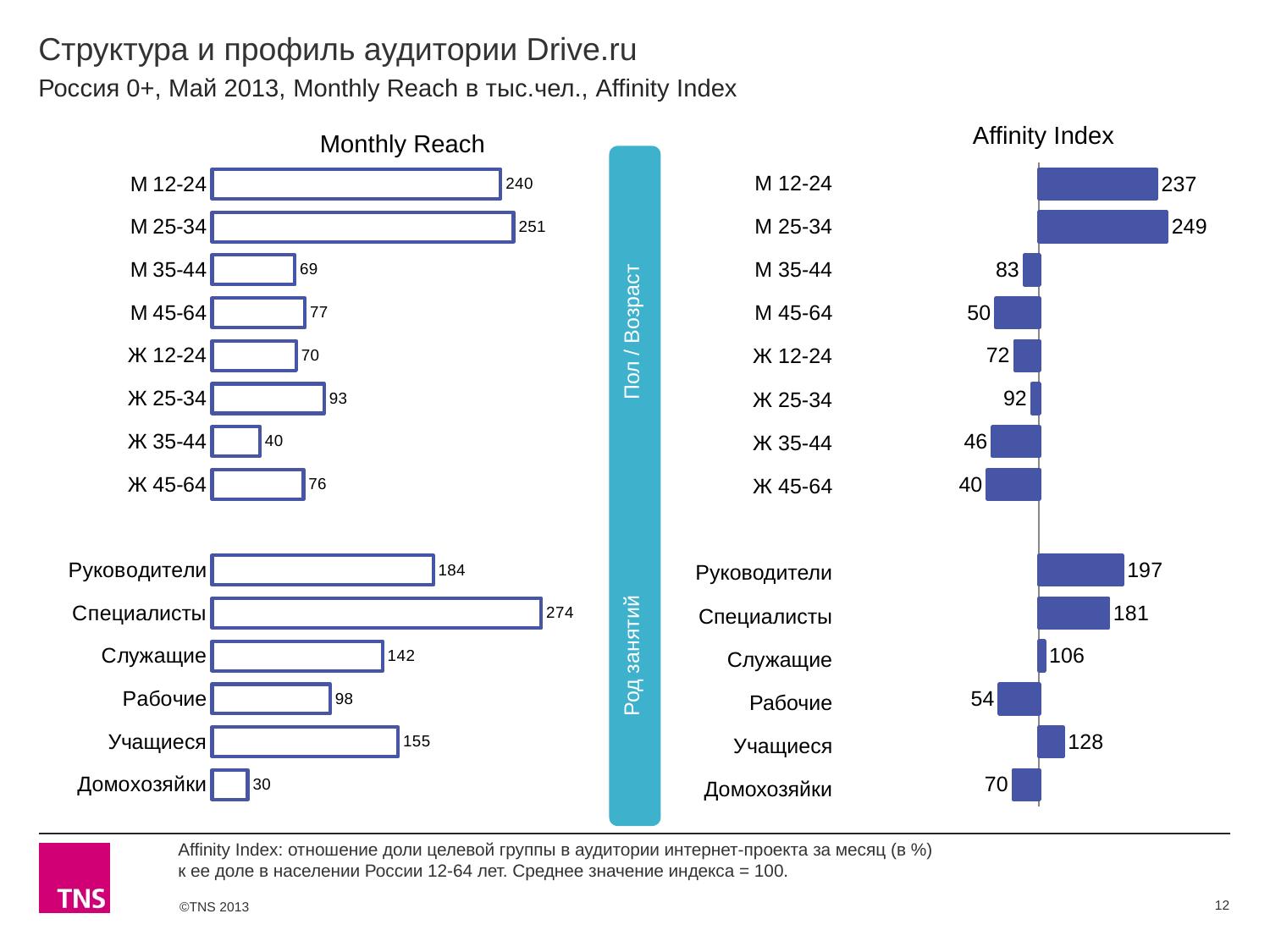
In the Affinity Index chart, what is the value for Учащиеся? 128 In the Monthly Reach chart, what is the value for Ж 35-44? 40 In the Affinity Index chart, which category has the lowest value? Ж 45-64 What type of chart is the Affinity Index chart? Bar chart How many categories are shown in the Monthly Reach chart? 14 In the Affinity Index chart, what is the difference between Руководители and Специалисты? 16 In the Monthly Reach chart, which category has the highest value? Специалисты In the Monthly Reach chart, which category has the lowest value? Домохозяйки In the Affinity Index chart, what is the value for М 25-34? 249 In the Monthly Reach chart, what is the difference between М 25-34 and М 12-24? 11 In the Affinity Index chart, which is larger, М 35-44 or Ж 25-34? Ж 25-34 In the Monthly Reach chart, what is the value for Специалисты? 274